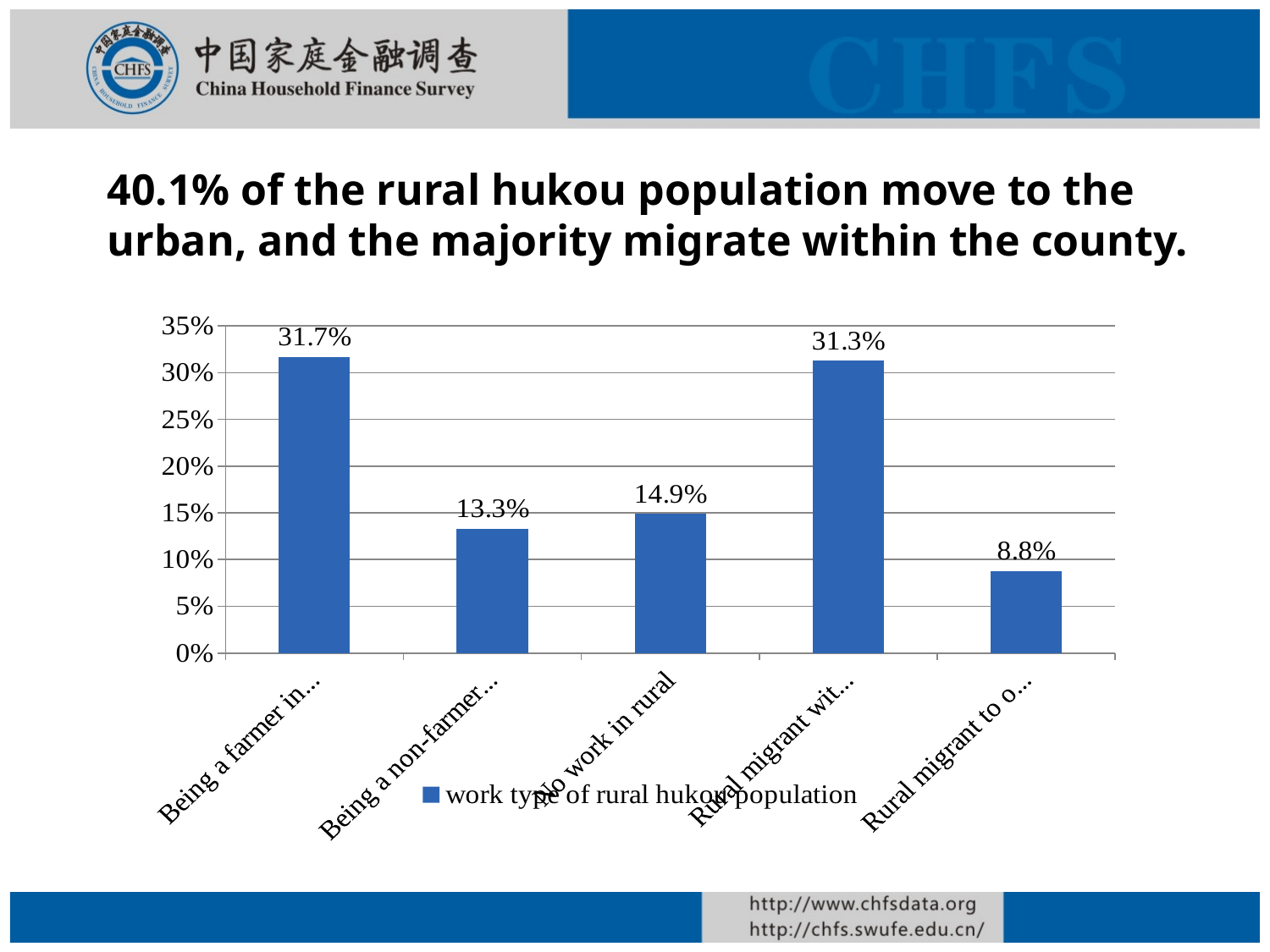
What is the value of the last bar, labelled "Rural migrant to o..."? 8.8% How many bars are shown in the chart? 5 Which category has the lowest value? Rural migrant to o... (the last bar) What is the value of the first bar, labelled "Being a farmer in..."? 31.7% What is the difference between the "No work in rural" value and the "Being a non-farmer..." value? 1.6% Which category has the highest value? Being a farmer in... (the first bar) What is the value of the second bar, labelled "Being a non-farmer..."? 13.3% What series name does the legend show? work type of rural hukou population What is the value for the "No work in rural" category? 14.9% Which is larger: the value for "No work in rural" or the value for "Rural migrant to o..."? No work in rural What type of chart is shown on the slide? Bar chart What is the value of the fourth bar, labelled "Rural migrant wit..."? 31.3%